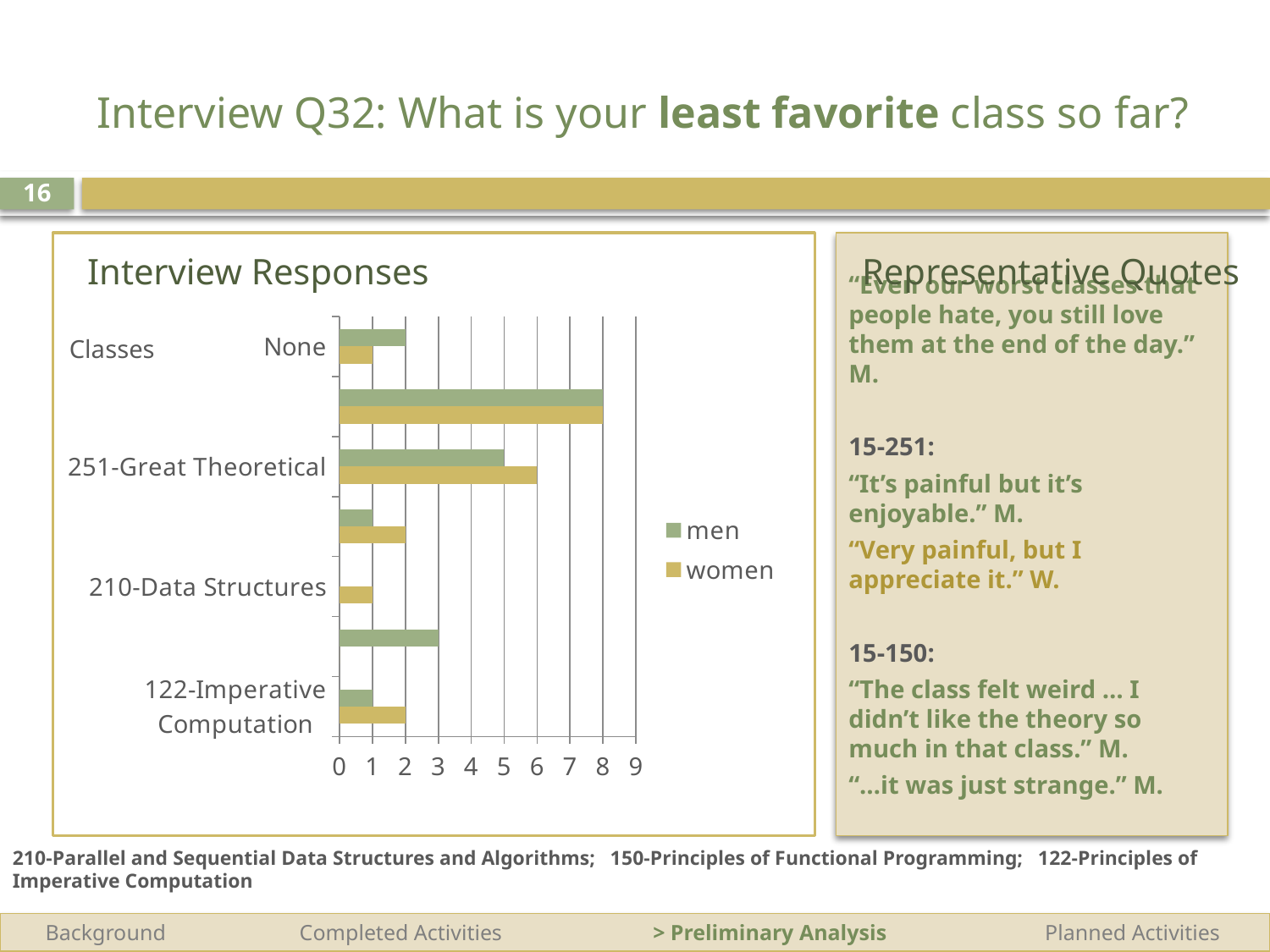
In the Interview Responses chart, what is the value for women for 122-Imperative Computation? 2 In the Interview Responses chart, what is the value for women in the "None" category? 1 In the Interview Responses chart, what is the value for women for 251-Great Theoretical? 6 In the Interview Responses chart, is the value for women for 251-Great Theoretical greater or less than 4? greater In the Interview Responses chart, what is the value for men for 122-Imperative Computation? 1 In the Interview Responses chart, what is the value for men in the "None" category? 2 In the Interview Responses chart, what is the value for men for 251-Great Theoretical? 5 What is the title of the chart on the left side of the slide? Interview Responses What kind of chart is shown under the title "Interview Responses"? bar chart In the Interview Responses chart, what is the difference between the women and men values for 251-Great Theoretical? 1 How many series does the legend of the Interview Responses chart list? 2 In the Interview Responses chart, which series has the larger value for 251-Great Theoretical, men or women? women